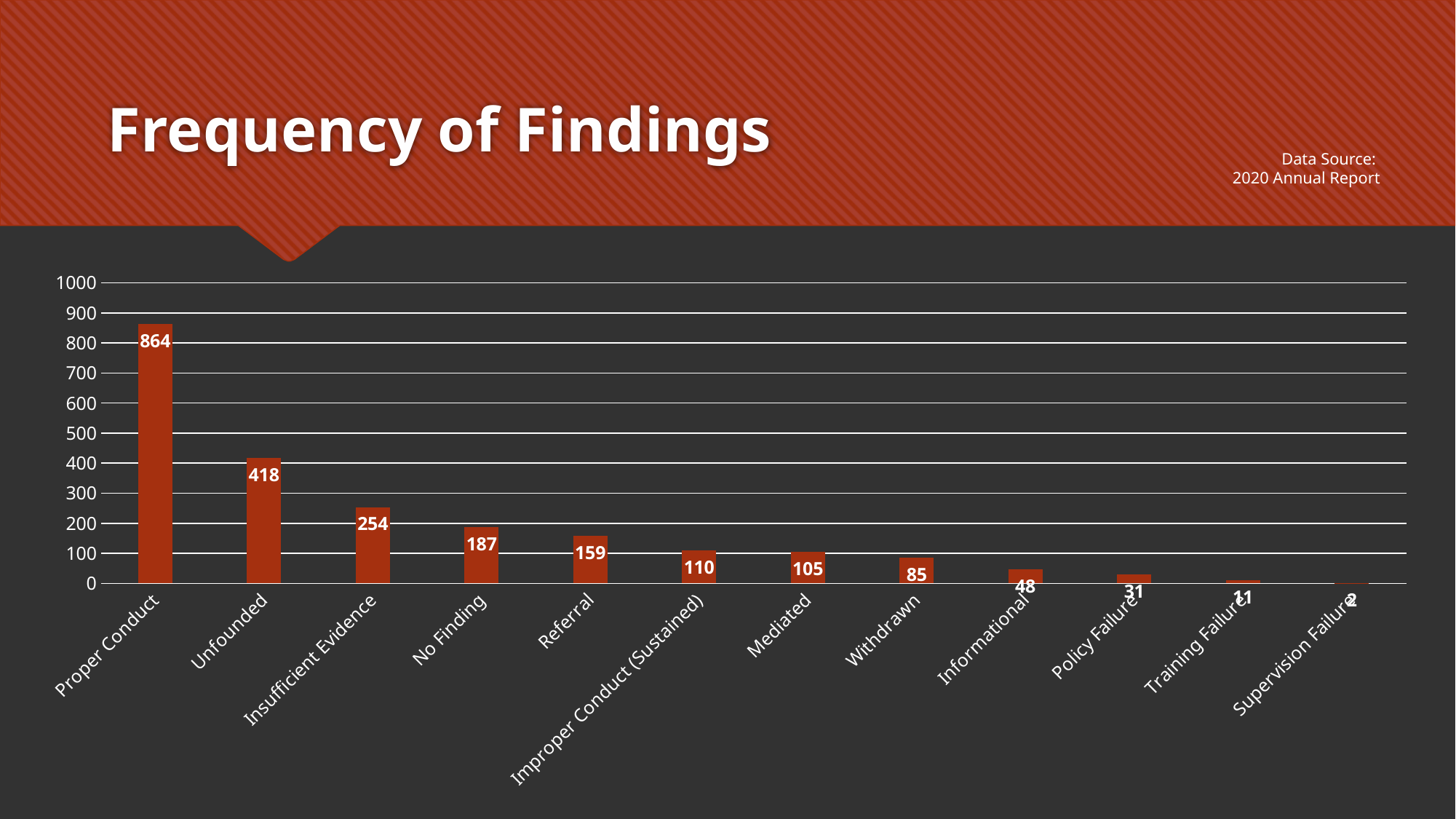
Do the values rise or fall moving from left to right along the x axis? fall What is the value for Insufficient Evidence? 254 What kind of chart is shown on the slide? bar chart How many categories are plotted in the chart? 12 What is the difference between the values for Proper Conduct and Unfounded? 446 What is the title of the chart? Frequency of Findings Which category has the lowest value? Supervision Failure What is the value for Mediated? 105 Which category has the highest value? Proper Conduct Which is larger, the value for No Finding or the value for Referral? No Finding What is the value for Unfounded? 418 What is the value for Proper Conduct? 864